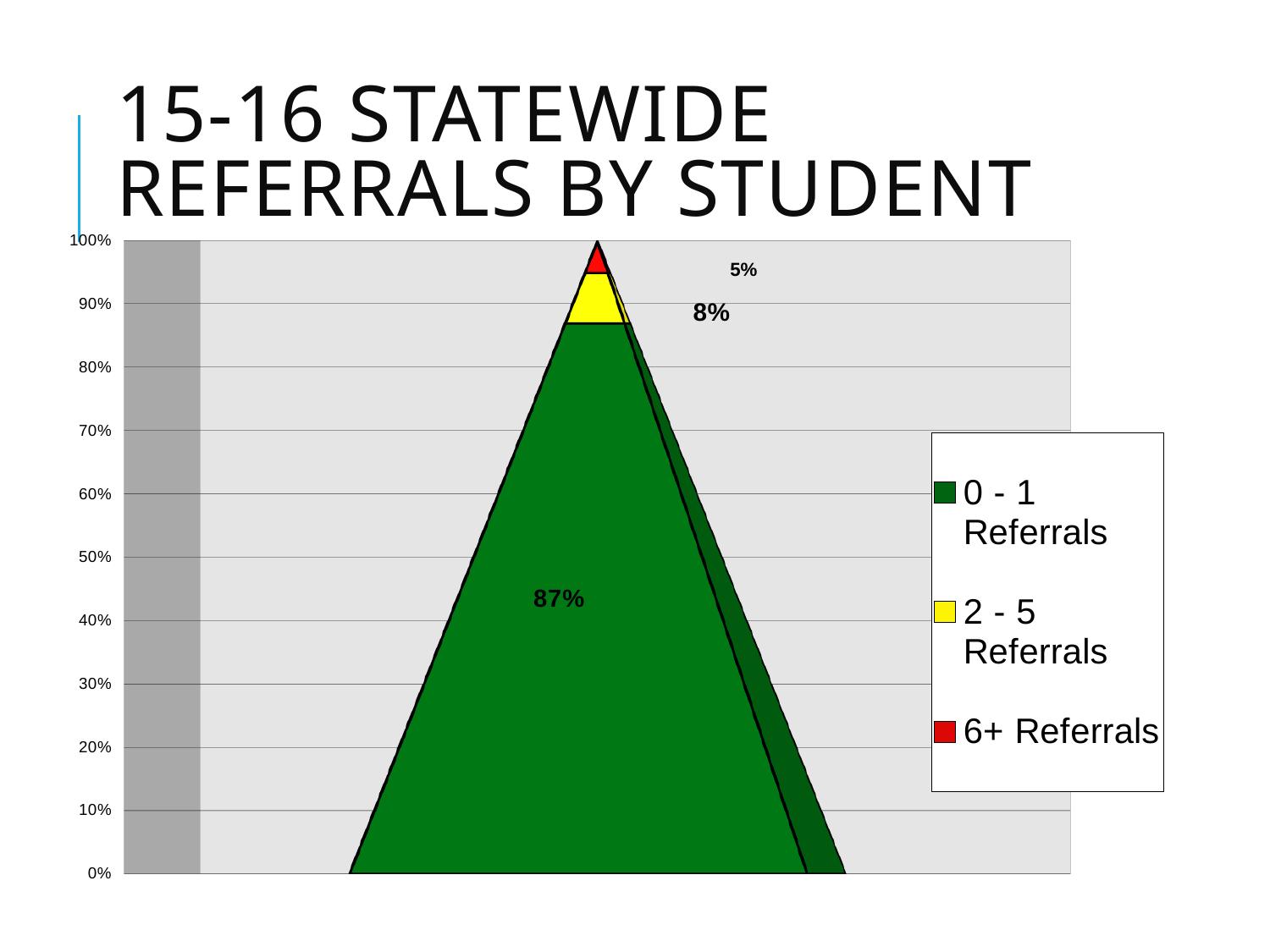
How many series does the legend list? 3 Which referral category has the largest share of students? 0 - 1 Referrals What is the difference in percentage points between the 0 - 1 Referrals and 2 - 5 Referrals segments? 79 Which referral category has the smallest share of students? 6+ Referrals What percentage of students had 6+ referrals? 5% What percentage of students had 2 - 5 referrals? 8% What is the difference in percentage points between the 2 - 5 Referrals and 6+ Referrals segments? 3 Which is larger, the share for 2 - 5 Referrals or the share for 6+ Referrals? 2 - 5 Referrals Is the value for 0 - 1 Referrals greater or less than 80%? greater What is the total of the three stacked segments? 100% What colour represents the 6+ Referrals series? Red What percentage of students had 0 - 1 referrals? 87%